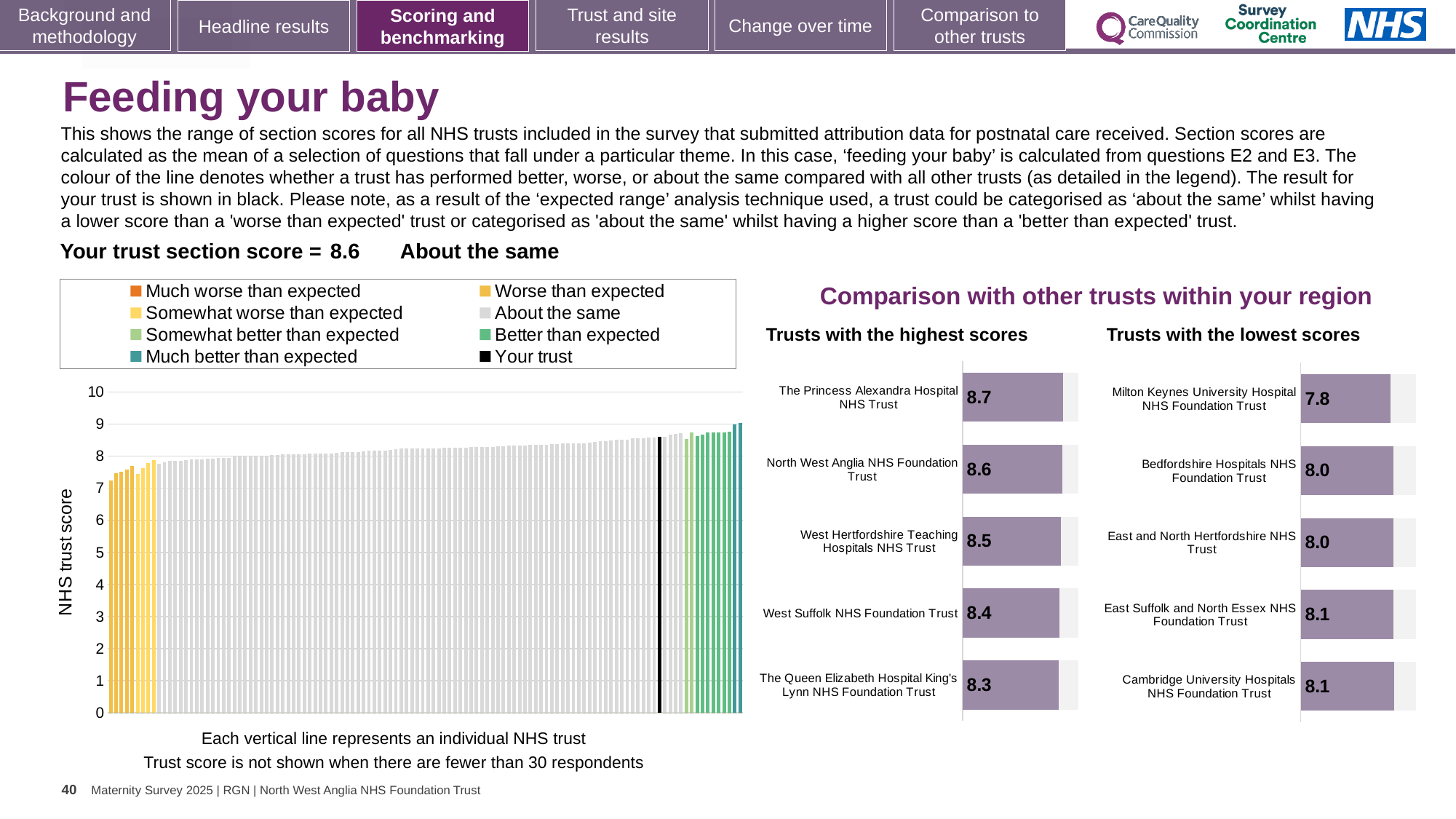
In the 'Trusts with the lowest scores' chart, which has the higher score: Bedfordshire Hospitals NHS Foundation Trust or Cambridge University Hospitals NHS Foundation Trust? Cambridge University Hospitals NHS Foundation Trust What kind of chart is the large chart on the left showing NHS trust scores? Bar chart In the 'Trusts with the lowest scores' chart, what is the score for Milton Keynes University Hospital NHS Foundation Trust? 7.8 In the 'Trusts with the highest scores' chart, which trust has the highest score? The Princess Alexandra Hospital NHS Trust How many trusts are shown in the 'Trusts with the highest scores' chart? 5 What is the y-axis label of the large chart on the left? NHS trust score In the large chart on the left, is the value of the black 'Your trust' bar greater or less than 8? greater In the 'Trusts with the highest scores' chart, what is the difference between the scores of The Princess Alexandra Hospital NHS Trust and The Queen Elizabeth Hospital King's Lynn NHS Foundation Trust? 0.4 In the 'Trusts with the highest scores' chart, what is the score for The Princess Alexandra Hospital NHS Trust? 8.7 In the large chart on the left, do the trust scores rise or fall from left to right? Rise In the 'Trusts with the lowest scores' chart, which trust has the lowest score? Milton Keynes University Hospital NHS Foundation Trust How many entries does the legend of the large chart on the left list? 8